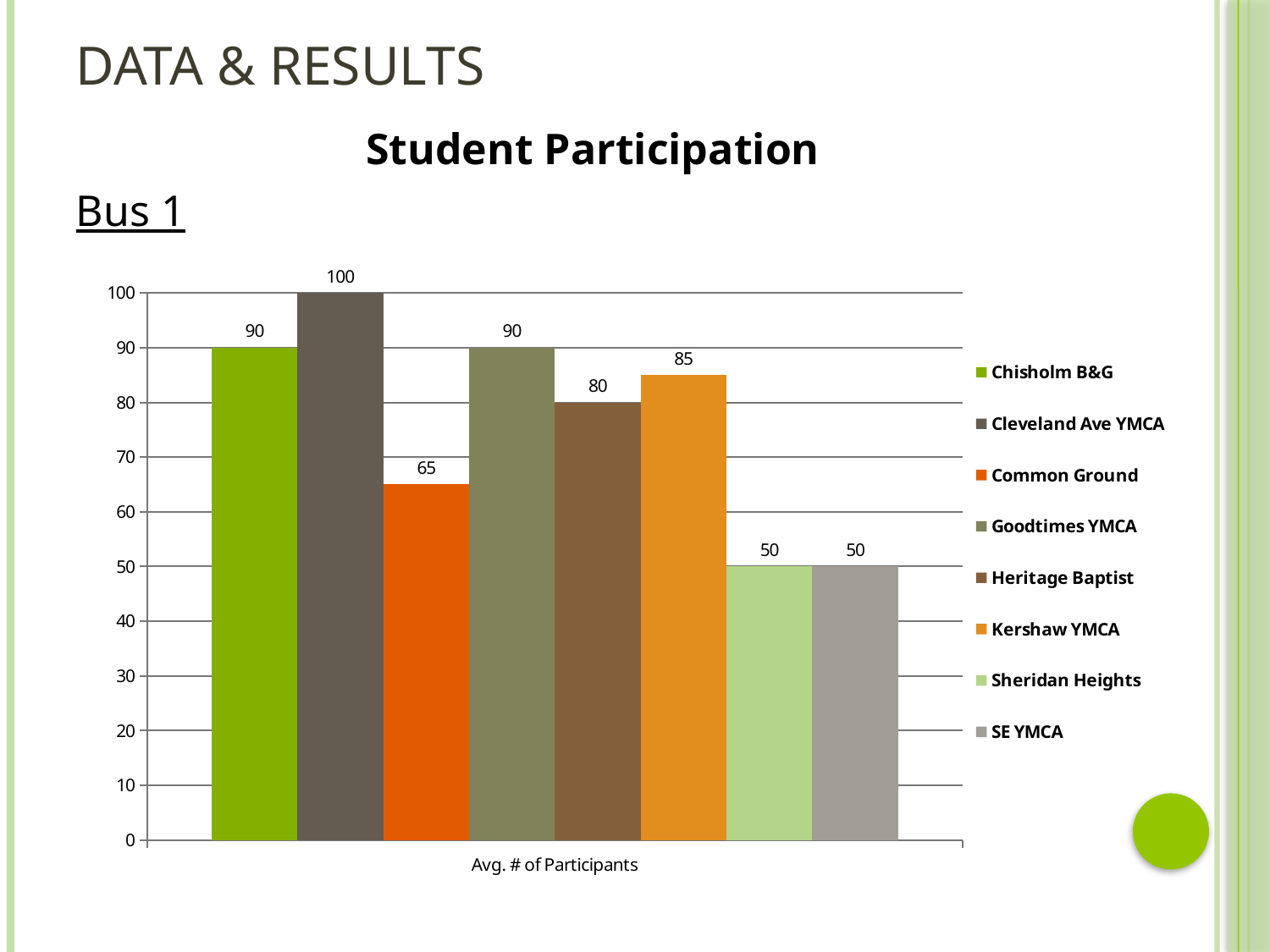
What is the difference in average participants between Goodtimes YMCA and Sheridan Heights? 40 What is the average number of participants for Cleveland Ave YMCA? 100 What is the average number of participants for Chisholm B&G? 90 Which has more average participants, Heritage Baptist or Kershaw YMCA? Kershaw YMCA What kind of chart is shown on the slide? Bar chart How many series does the legend list? 8 Which two sites share the lowest average number of participants? Sheridan Heights and SE YMCA What is the difference in average participants between Cleveland Ave YMCA and Common Ground? 35 What is the label on the x axis of the chart? Avg. # of Participants What is the average number of participants for Common Ground? 65 Which site has the highest average number of participants? Cleveland Ave YMCA What is the average number of participants for Kershaw YMCA? 85